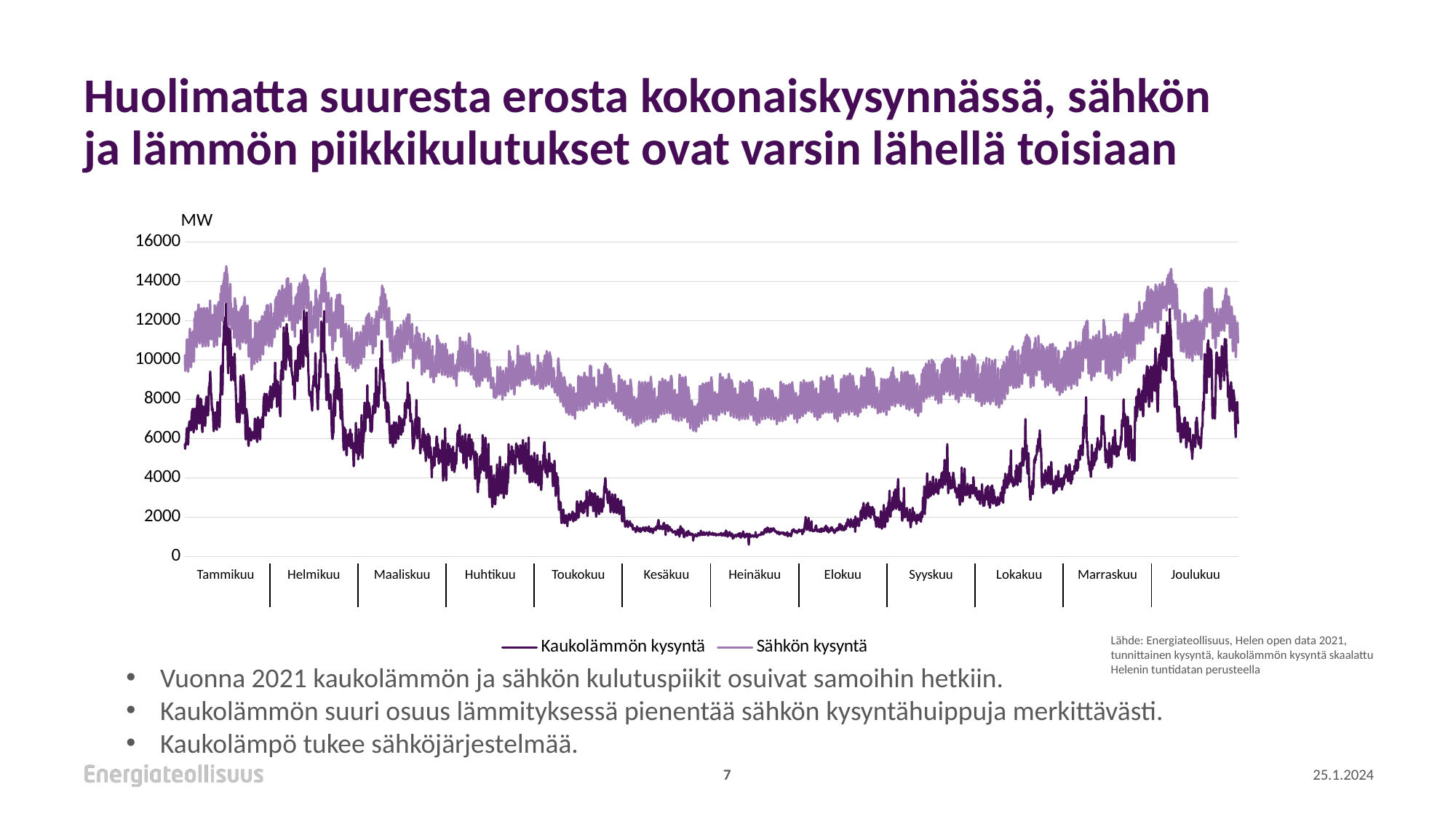
What kind of chart is shown on the slide? line chart How many months are labelled along the x axis? 12 Does Kaukolämmön kysyntä rise or fall from Heinäkuu to Joulukuu? rise Is the value of Kaukolämmön kysyntä in Heinäkuu greater or less than 2000? less How many series does the legend list? 2 Which series has the higher values in Heinäkuu, Kaukolämmön kysyntä or Sähkön kysyntä? Sähkön kysyntä Does Kaukolämmön kysyntä rise or fall from Tammikuu to Heinäkuu? fall Is the value of Sähkön kysyntä in Heinäkuu greater or less than 6000? greater What are the two series named in the legend? Kaukolämmön kysyntä and Sähkön kysyntä Is the peak value of Sähkön kysyntä in Tammikuu greater or less than 16000? less What unit is shown on the y axis? MW